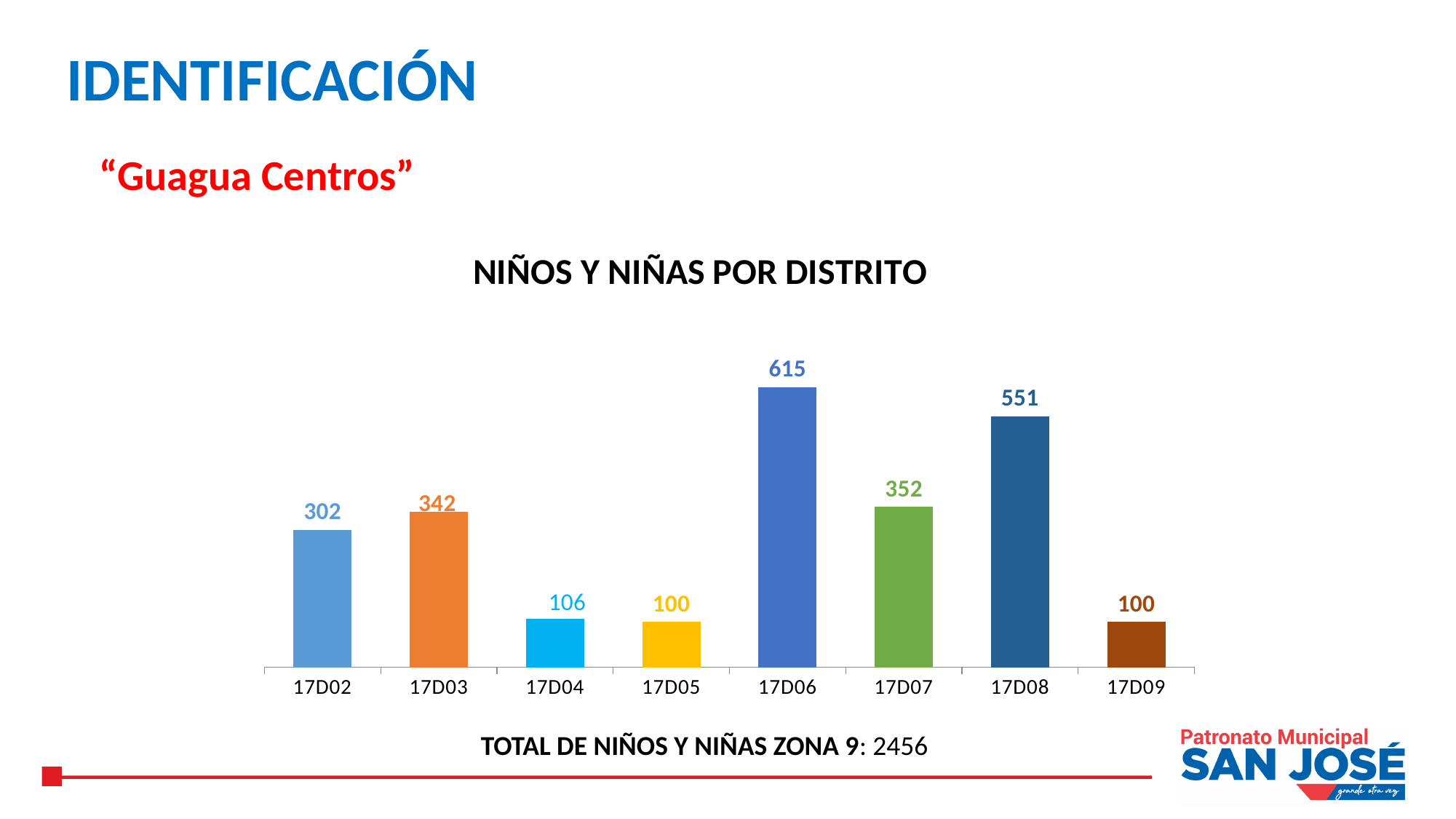
Which is larger, the value for 17D07 or the value for 17D03? 17D07 What total is stated below the chart for Zona 9? 2456 What is the value for 17D07? 352 What is the difference between the values for 17D06 and 17D08? 64 How many districts are shown on the x axis? 8 What kind of chart is shown? bar chart What is the value for 17D02? 302 What is the difference between the values for 17D03 and 17D02? 40 Which is larger, the value for 17D04 or the value for 17D05? 17D04 What is the value for 17D06? 615 What is the title of the chart? NIÑOS Y NIÑAS POR DISTRITO Which district has the highest value? 17D06